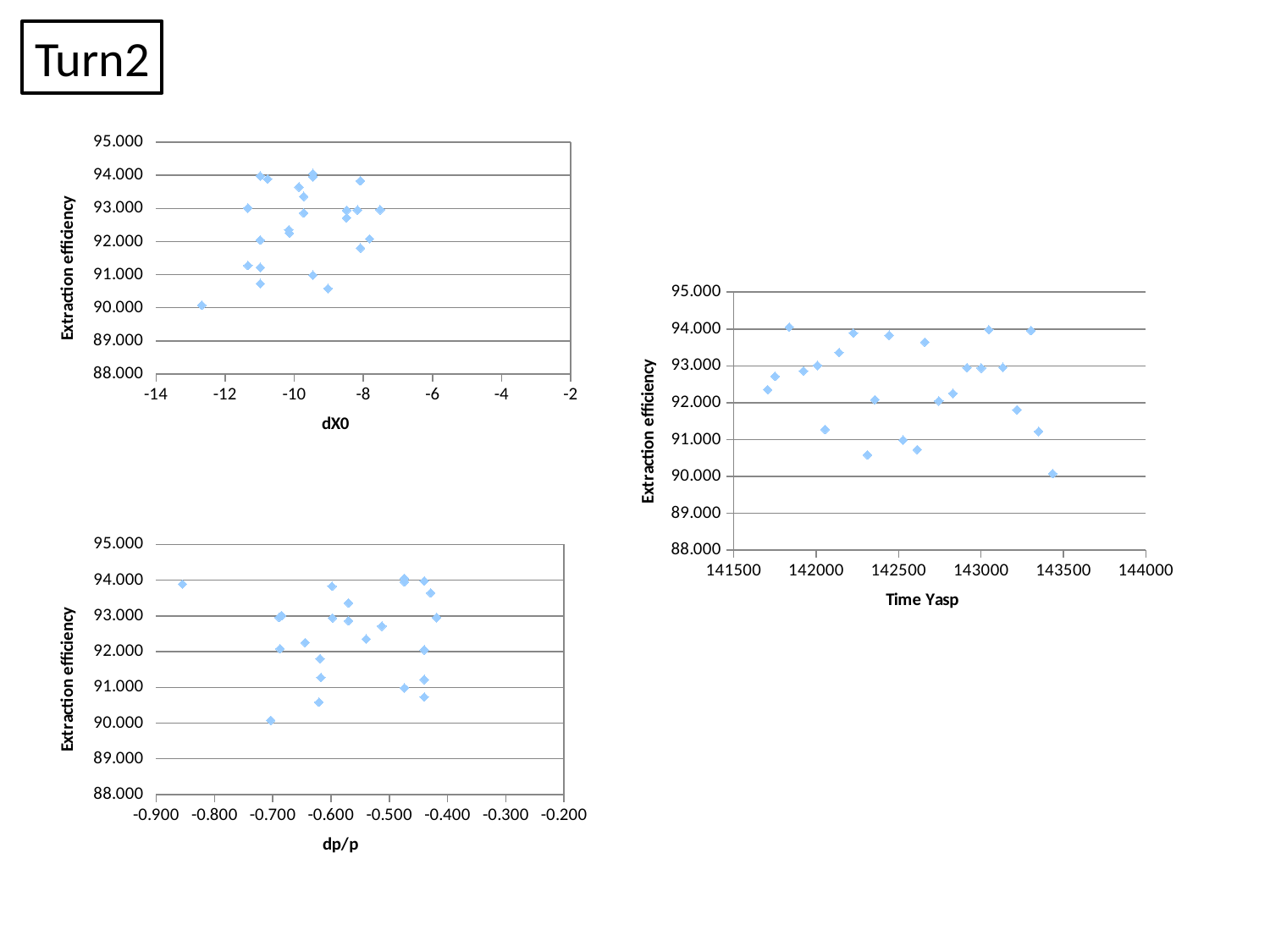
In the chart on the right (Time Yasp), is the extraction efficiency of the highest point greater or less than 93.000? greater In the bottom-left chart (dp/p), is the extraction efficiency of the point with the lowest dp/p value greater or less than 93.000? greater In the chart on the right (Time Yasp), is the extraction efficiency of the point with the smallest Time Yasp value greater or less than 92.000? greater What kind of chart is the chart on the right with the x axis labelled Time Yasp? scatter chart What is the y-axis label shared by all three charts on the slide? Extraction efficiency What kind of chart is the top-left chart with the x axis labelled dX0? scatter chart What kind of chart is the bottom-left chart with the x axis labelled dp/p? scatter chart What is the x-axis label of the chart on the right side of the slide? Time Yasp